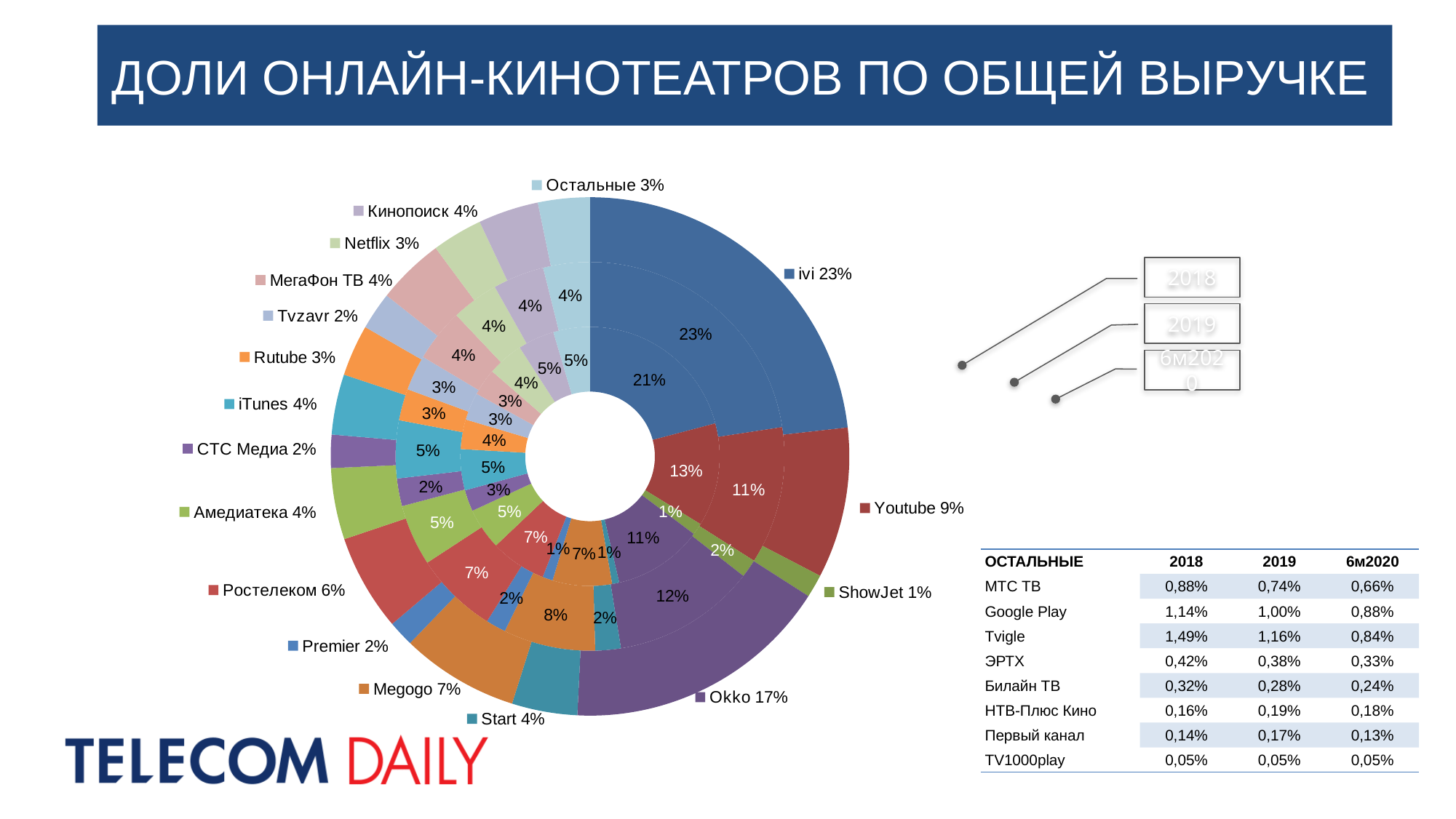
What share is labelled for Megogo in the chart legend? 7% Which online cinema has the smallest labelled share in the chart? ShowJet What is the difference between the labelled shares of ivi and Okko? 6 percentage points What share is labelled for Okko in the chart legend? 17% What share is labelled for Youtube in the chart legend? 9% Which online cinema has the largest labelled share in the chart? ivi What share is labelled for ivi in the chart legend? 23% How many categories are labelled around the chart? 17 Which has the larger labelled share, Megogo or Ростелеком? Megogo What kind of chart is shown on the slide? Doughnut (pie) chart with multiple rings Which three periods are labelled for the rings of the chart? 2018, 2019, 6м2020 What is the title of the slide? ДОЛИ ОНЛАЙН-КИНОТЕАТРОВ ПО ОБЩЕЙ ВЫРУЧКЕ